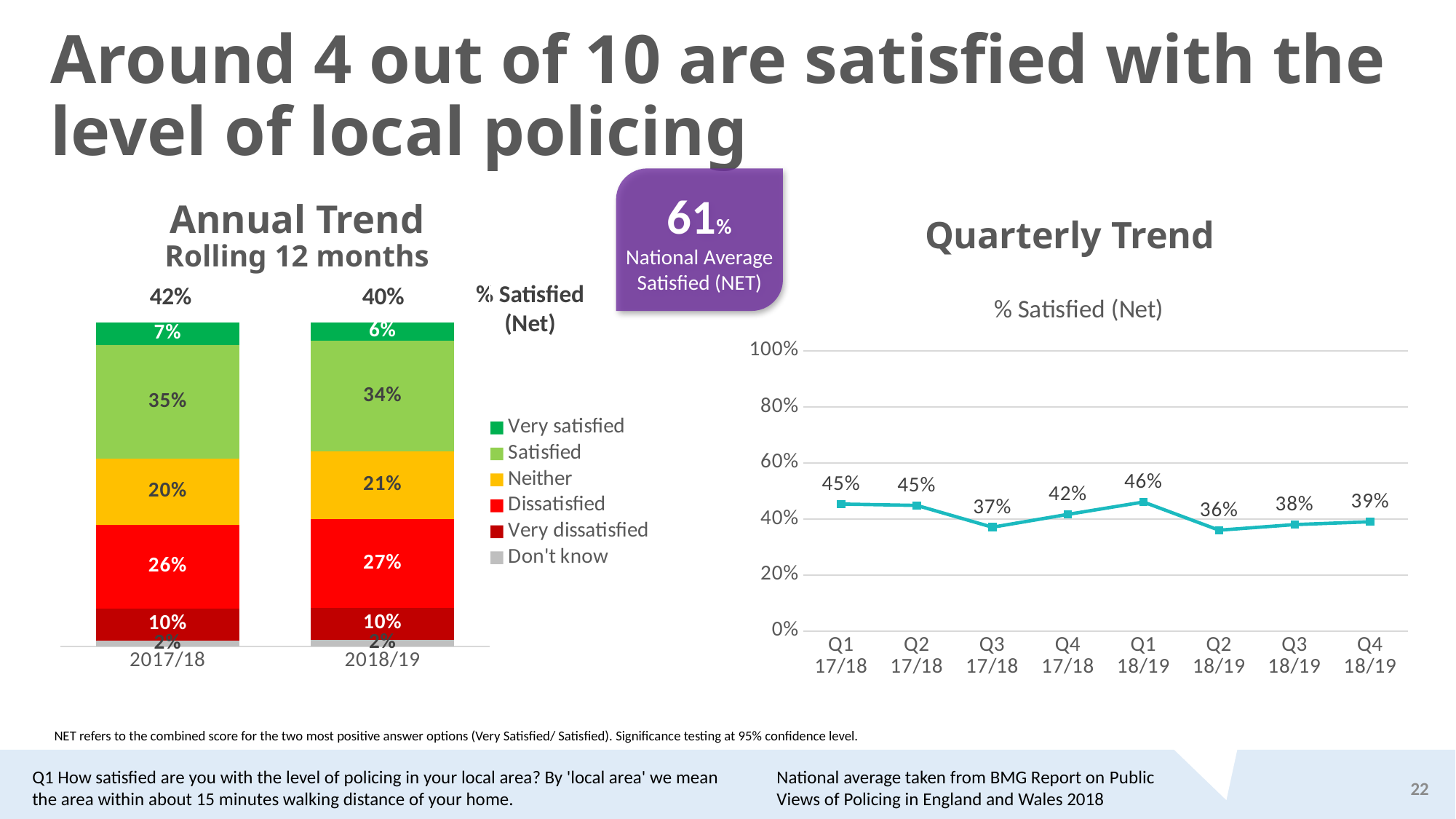
In the Annual Trend chart, what percentage were Satisfied in 2017/18? 35% In the Annual Trend chart, what is the % Satisfied (Net) for 2018/19? 40% In the Quarterly Trend chart, which quarter has the highest % Satisfied (Net)? Q1 18/19 In the Annual Trend chart, what is the difference between the Neither values for 2018/19 and 2017/18? 1% In the Annual Trend chart, which year has the larger Very satisfied value, 2017/18 or 2018/19? 2017/18 In the Quarterly Trend chart, how many quarters are plotted? 8 In the Quarterly Trend chart, what is the % Satisfied (Net) for Q3 17/18? 37% In the Annual Trend chart, what percentage were Dissatisfied in 2018/19? 27% What kind of chart is the Quarterly Trend chart? Line chart In the Quarterly Trend chart, which quarter has the lowest % Satisfied (Net)? Q2 18/19 In the Annual Trend chart, how many series does the legend list? 6 In the Quarterly Trend chart, what is the difference between Q1 18/19 and Q2 18/19? 10%